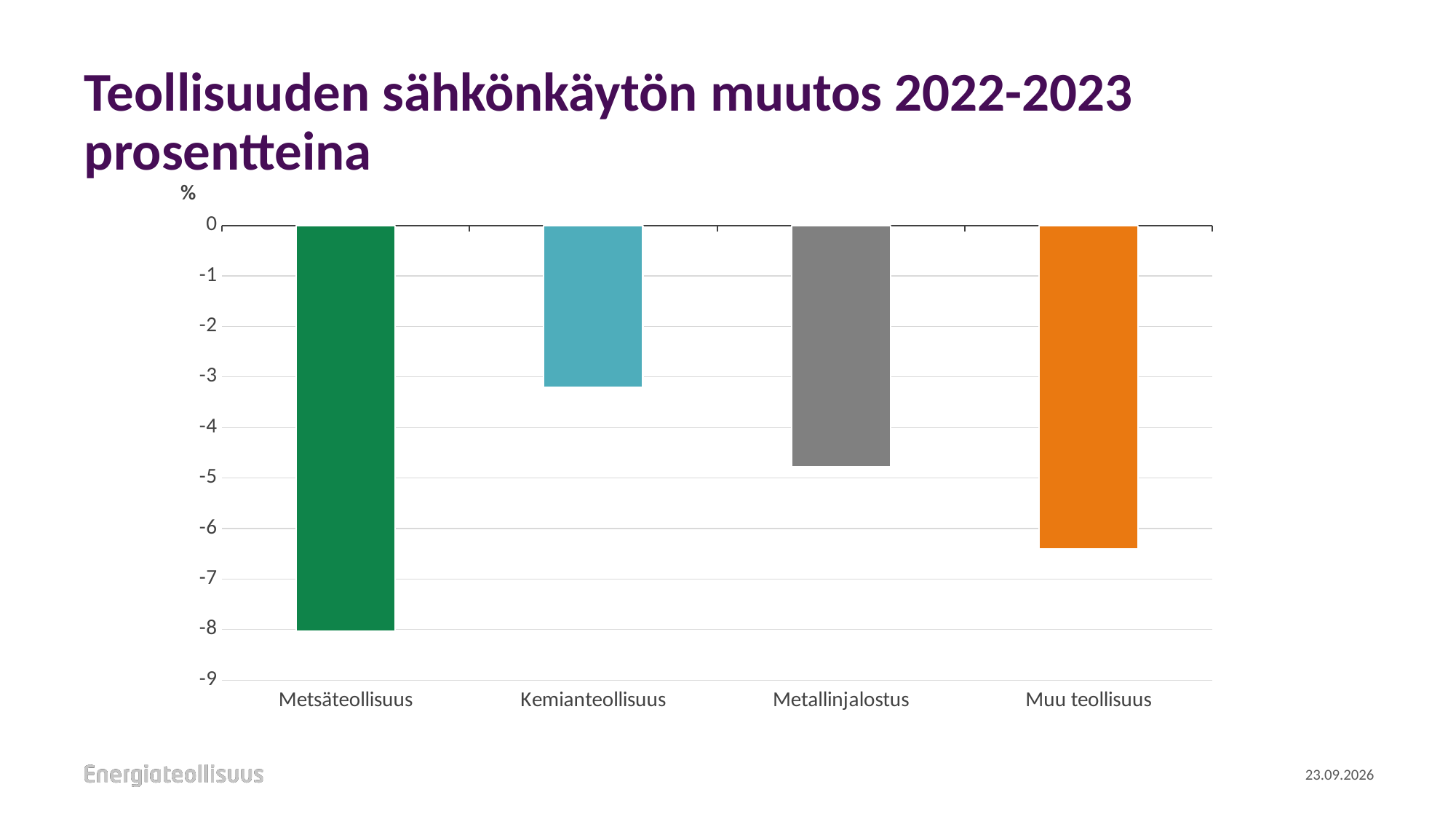
Is the value for Muu teollisuus greater or less than -7? greater What is the title of the chart? Teollisuuden sähkönkäytön muutos 2022-2023 prosentteina Which category has the lowest value (largest decrease)? Metsäteollisuus Is the value for Metallinjalostus greater or less than -5? greater What kind of chart is shown on the slide? bar chart Is the value for Kemianteollisuus greater or less than -2? less How many industry categories are shown on the x axis? 4 What unit is shown at the top of the vertical axis? % Which is larger, the value for Metallinjalostus or the value for Muu teollisuus? Metallinjalostus Which category has the highest value (smallest decrease)? Kemianteollisuus